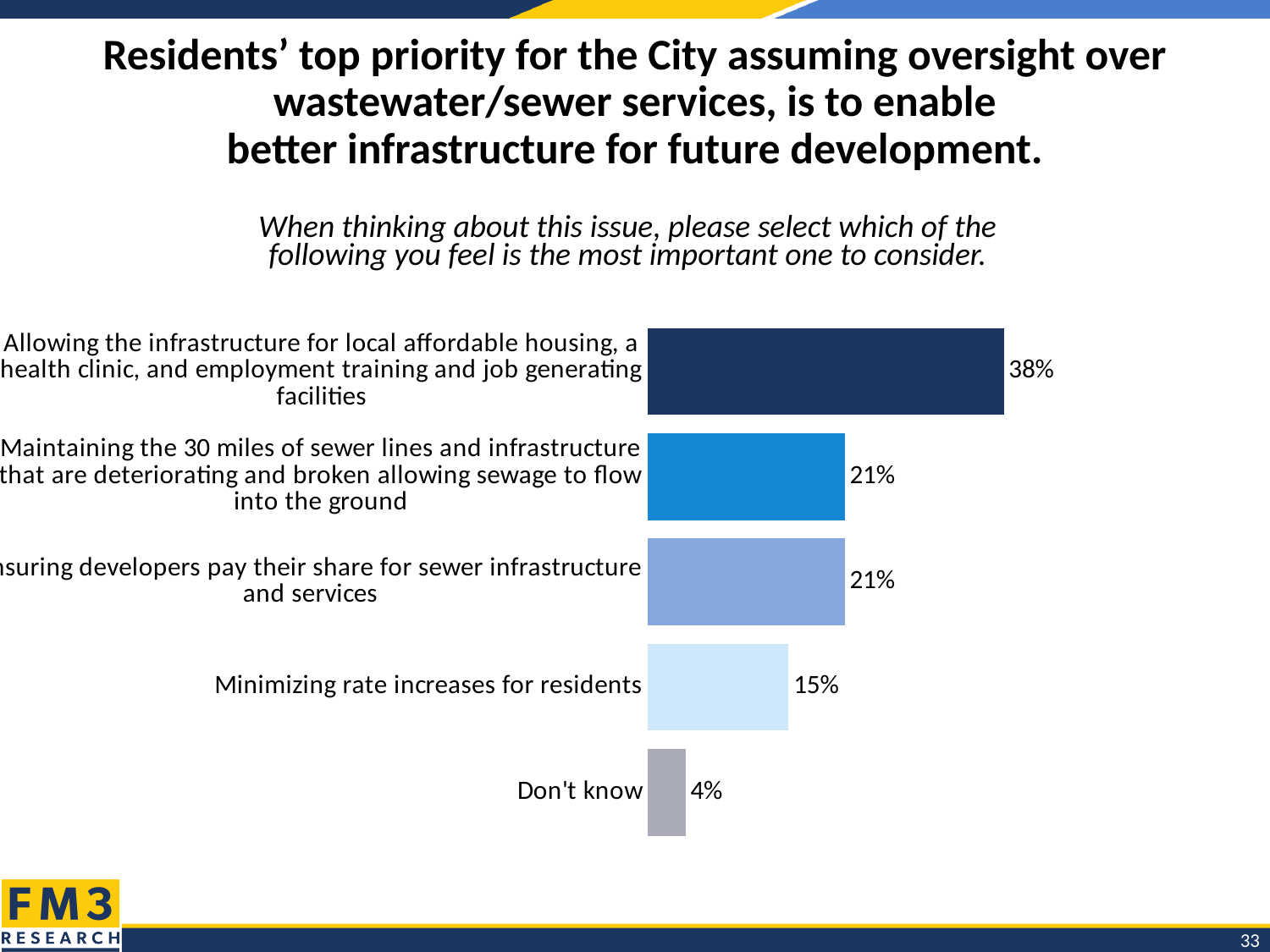
How many response categories are shown on the chart? 5 Which option received the highest percentage of residents? Allowing the infrastructure for local affordable housing, a health clinic, and employment training and job generating facilities What percentage of residents selected minimizing rate increases for residents? 15% What type of chart is shown on the slide? Bar chart What percentage of residents selected allowing the infrastructure for local affordable housing, a health clinic, and employment training and job generating facilities as most important? 38% Which category has the lowest percentage on the chart? Don't know Which is larger: the percentage for ensuring developers pay their share for sewer infrastructure and services, or the percentage for minimizing rate increases for residents? Ensuring developers pay their share for sewer infrastructure and services What colour is the bar for the "Don't know" category? Grey What percentage of residents selected maintaining the 30 miles of sewer lines and infrastructure that are deteriorating and broken? 21% How many percentage points higher is the affordable housing/health clinic/job facilities option than the maintaining sewer lines option? 17 percentage points What percentage of residents answered "Don't know"? 4% What is the difference between the percentage for minimizing rate increases for residents and the percentage for "Don't know"? 11 percentage points